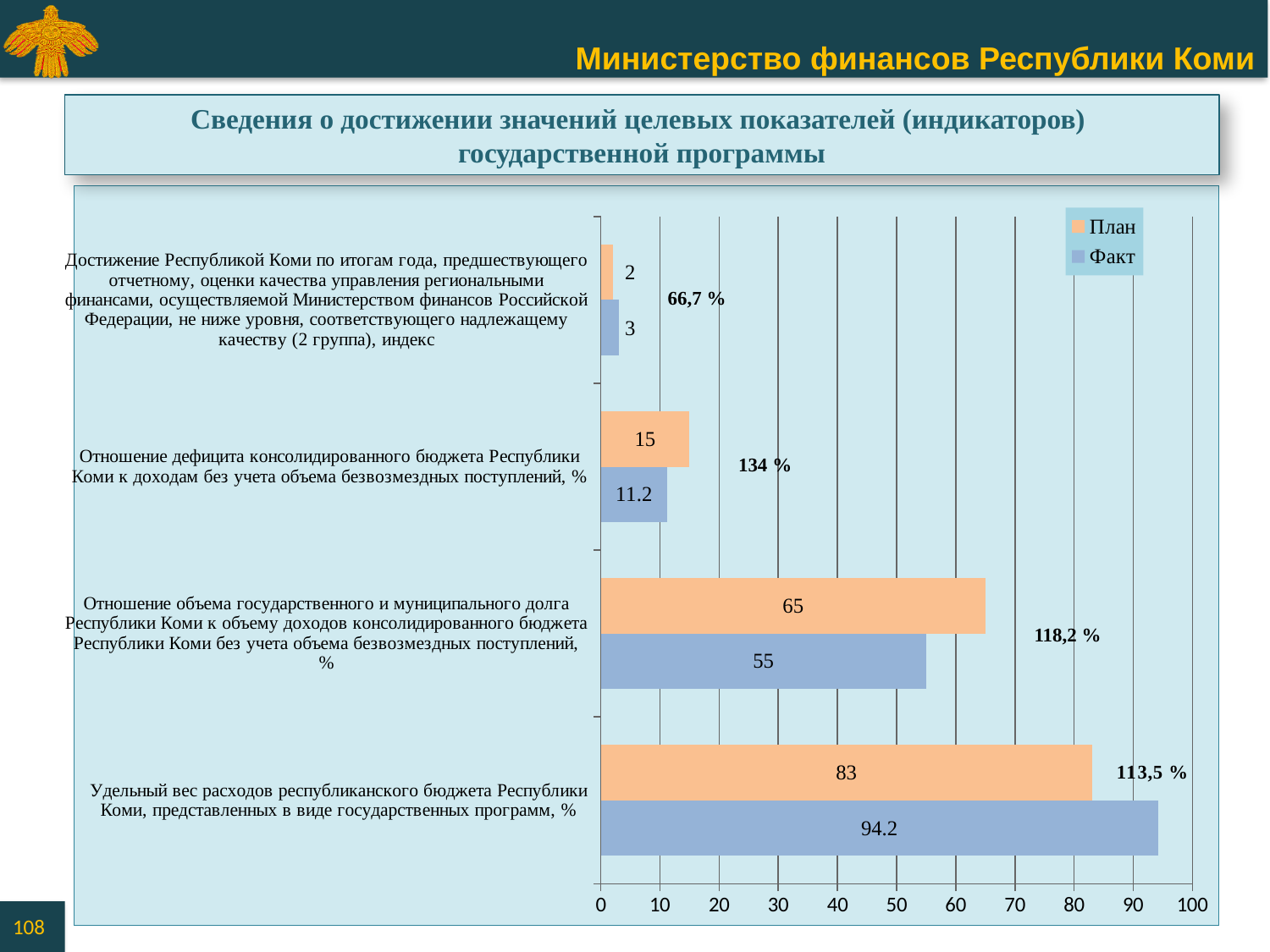
How many series does the legend list? 2 What is the Факт value for "Отношение дефицита консолидированного бюджета Республики Коми к доходам без учета объема безвозмездных поступлений, %"? 11.2 What is the План value for "Отношение объема государственного и муниципального долга Республики Коми к объему доходов консолидированного бюджета Республики Коми без учета объема безвозмездных поступлений, %"? 65 What type of chart is shown on the slide? bar chart Is the Факт value for "Удельный вес расходов республиканского бюджета Республики Коми, представленных в виде государственных программ, %" greater or less than 90? greater How many categories are shown on the chart? 4 What is the Факт value for "Удельный вес расходов республиканского бюджета Республики Коми, представленных в виде государственных программ, %"? 94.2 For "Отношение дефицита консолидированного бюджета Республики Коми к доходам без учета объема безвозмездных поступлений, %", which is larger, План or Факт? План What is the difference between the План and Факт values for "Отношение объема государственного и муниципального долга Республики Коми к объему доходов консолидированного бюджета Республики Коми без учета объема безвозмездных поступлений, %"? 10 What is the План value for "Удельный вес расходов республиканского бюджета Республики Коми, представленных в виде государственных программ, %"? 83 Which category has the highest Факт value? Удельный вес расходов республиканского бюджета Республики Коми, представленных в виде государственных программ, %